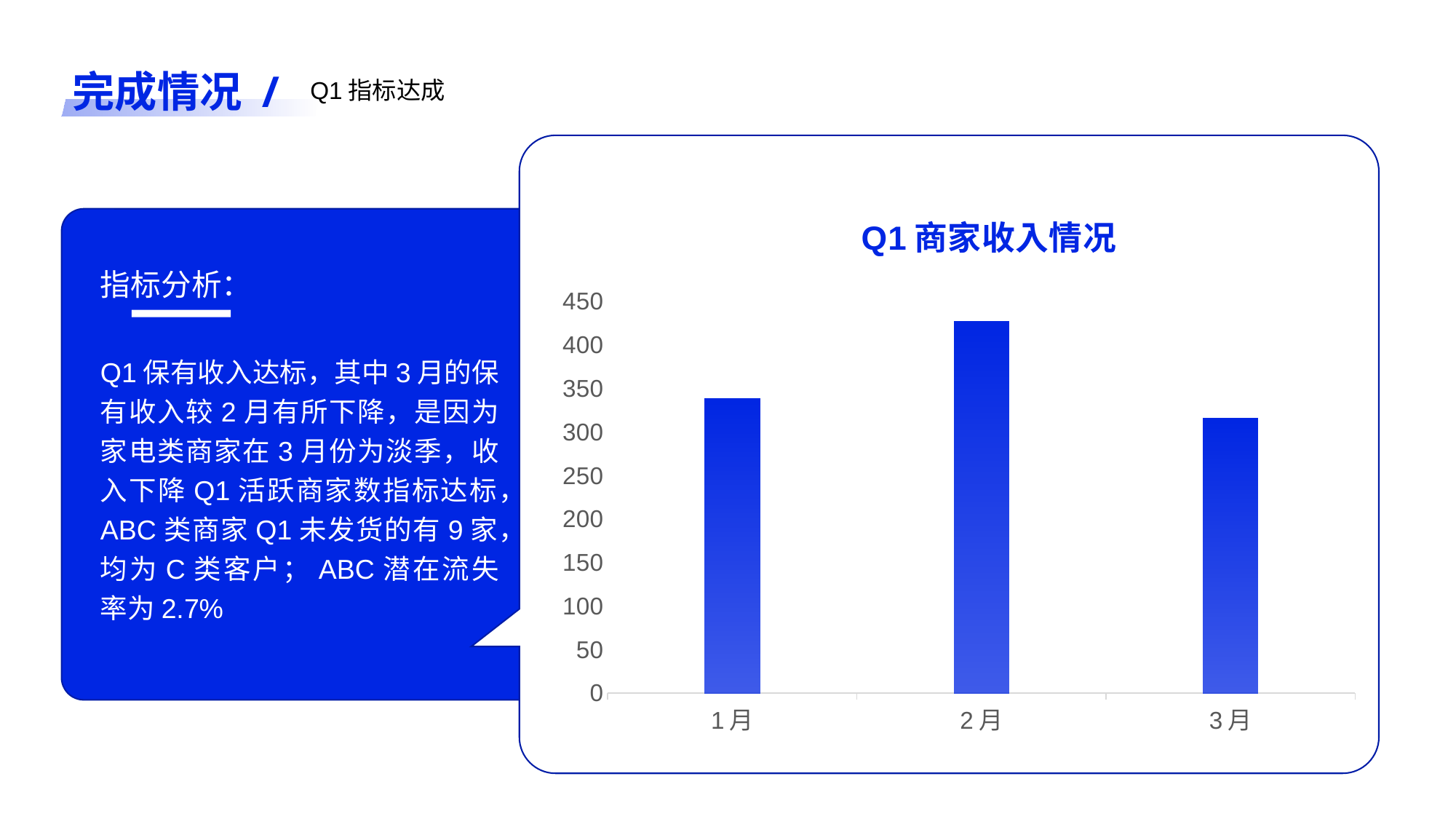
Is the value for 1月 greater or less than 400? less Is the value for 2月 greater or less than 400? greater What kind of chart is shown on the slide? bar chart Is the value for 1月 greater or less than 300? greater Which is larger, the value for 2月 or the value for 1月? 2月 Which month has the highest value in the chart? 2月 Does the value rise or fall from 2月 to 3月? fall What is the title of the chart? Q1 商家收入情况 Which month has the lowest value in the chart? 3月 How many categories are shown on the x axis of the chart? 3 Which is larger, the value for 1月 or the value for 3月? 1月